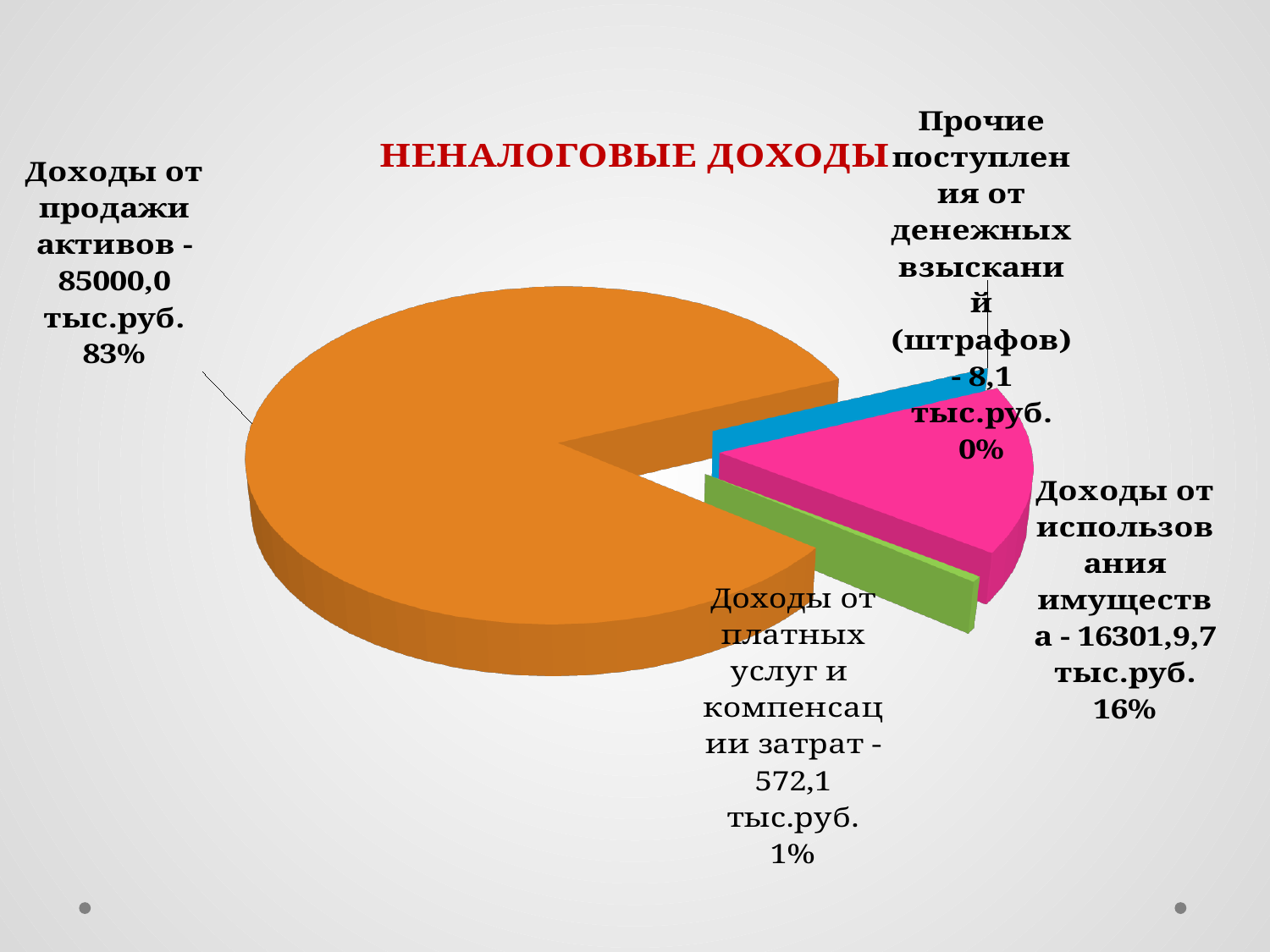
What is the title of the chart? НЕНАЛОГОВЫЕ ДОХОДЫ What is the value shown for "Прочие поступления от денежных взысканий (штрафов)"? 8,1 тыс.руб. What kind of chart is shown on the slide? pie chart Which category has the largest slice of the pie? Доходы от продажи активов What share of the pie is "Прочие поступления от денежных взысканий (штрафов)"? 0% What is the value shown for "Доходы от платных услуг и компенсации затрат"? 572,1 тыс.руб. What share of the pie is "Доходы от использования имущества"? 16% What share of the pie is "Доходы от платных услуг и компенсации затрат"? 1% What is the value shown for "Доходы от продажи активов"? 85000,0 тыс.руб. Which is larger: "Доходы от использования имущества" or "Доходы от платных услуг и компенсации затрат"? Доходы от использования имущества How many slices does the pie chart have? 4